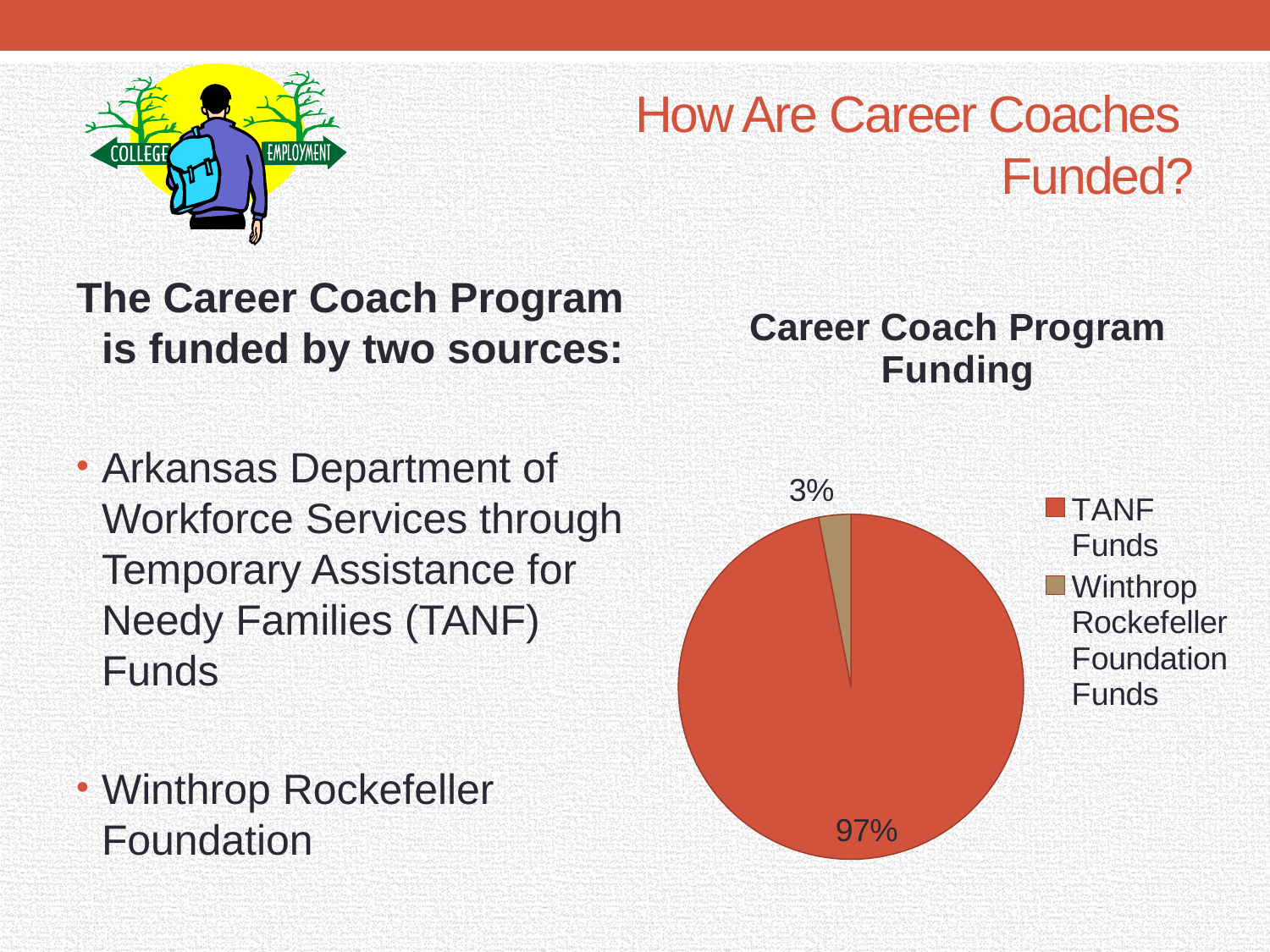
Which funding source has the smallest slice of the pie? Winthrop Rockefeller Foundation Funds Which is larger, the TANF Funds slice or the Winthrop Rockefeller Foundation Funds slice? TANF Funds What is the title of the chart? Career Coach Program Funding What colour is the TANF Funds slice in the pie chart? red-orange What kind of chart is shown on the slide? pie chart How many entries does the legend list? 2 What is the difference in percentage points between the TANF Funds slice and the Winthrop Rockefeller Foundation Funds slice? 94 Which funding source has the largest slice of the pie? TANF Funds How many slices does the pie chart have? 2 What share of the pie is Winthrop Rockefeller Foundation Funds? 3% What share of the pie is TANF Funds? 97%